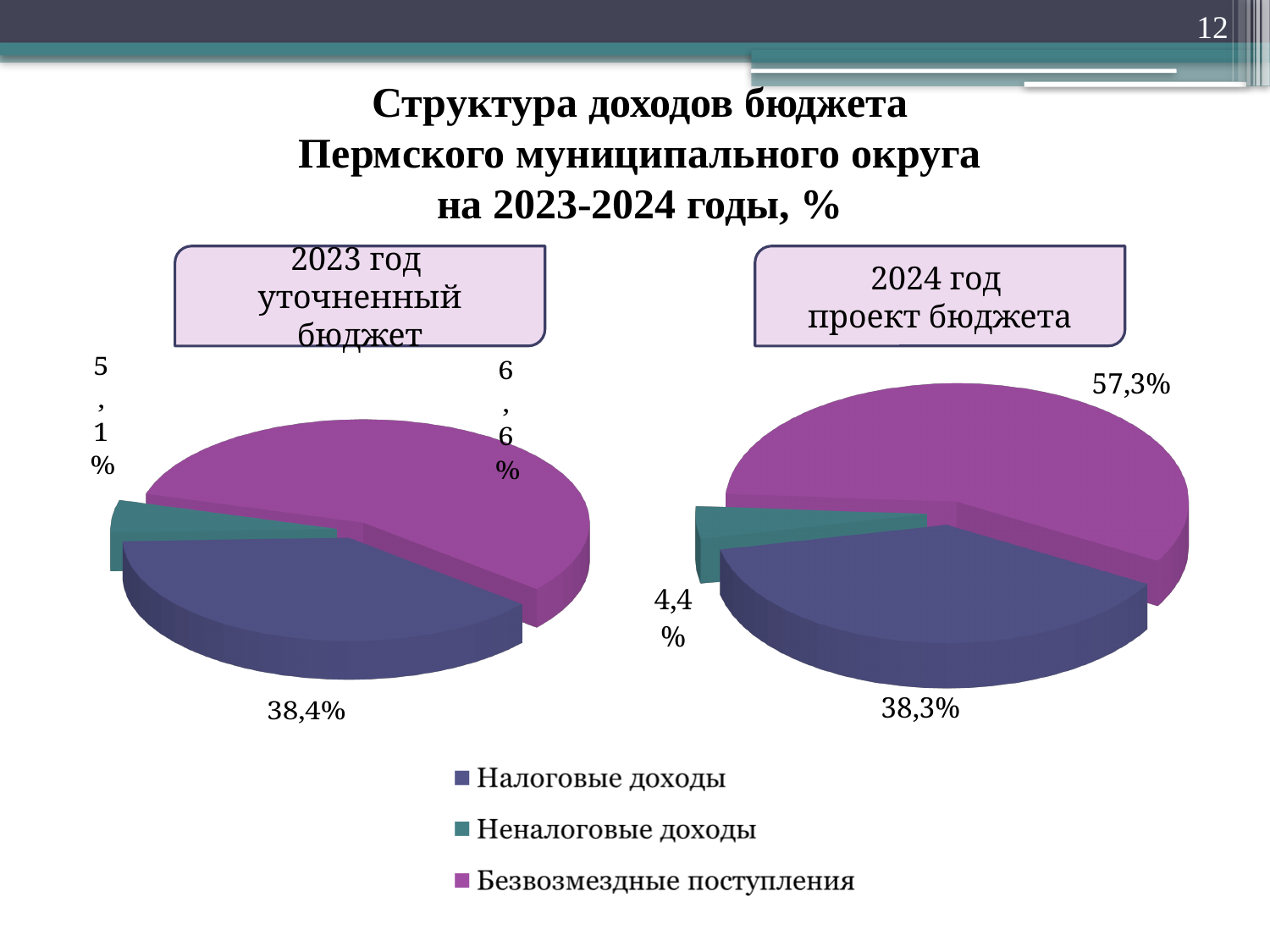
In the 2024 год проект бюджета pie chart, what is the share of Неналоговые доходы? 4,4% In the 2023 год уточненный бюджет pie chart, what is the share of Неналоговые доходы? 5,1% In the 2023 год уточненный бюджет pie chart, what is the share of Налоговые доходы? 38,4% What type of chart is used for the 2023 год уточненный бюджет data? Pie chart In the 2023 год уточненный бюджет pie chart, what is the difference in percentage points between Налоговые доходы and Неналоговые доходы? 33,3 In the 2024 год проект бюджета pie chart, what is the share of Безвозмездные поступления? 57,3% How many categories does the legend list for the pie charts? 3 In the 2024 год проект бюджета pie chart, which category has the largest slice? Безвозмездные поступления In the 2024 год проект бюджета pie chart, what is the share of Налоговые доходы? 38,3% In the 2024 год проект бюджета pie chart, which category has the smallest slice? Неналоговые доходы In the 2024 год проект бюджета pie chart, how many percentage points larger is Безвозмездные поступления than Налоговые доходы? 19 In the 2024 год проект бюджета pie chart, which is larger: Налоговые доходы or Неналоговые доходы? Налоговые доходы